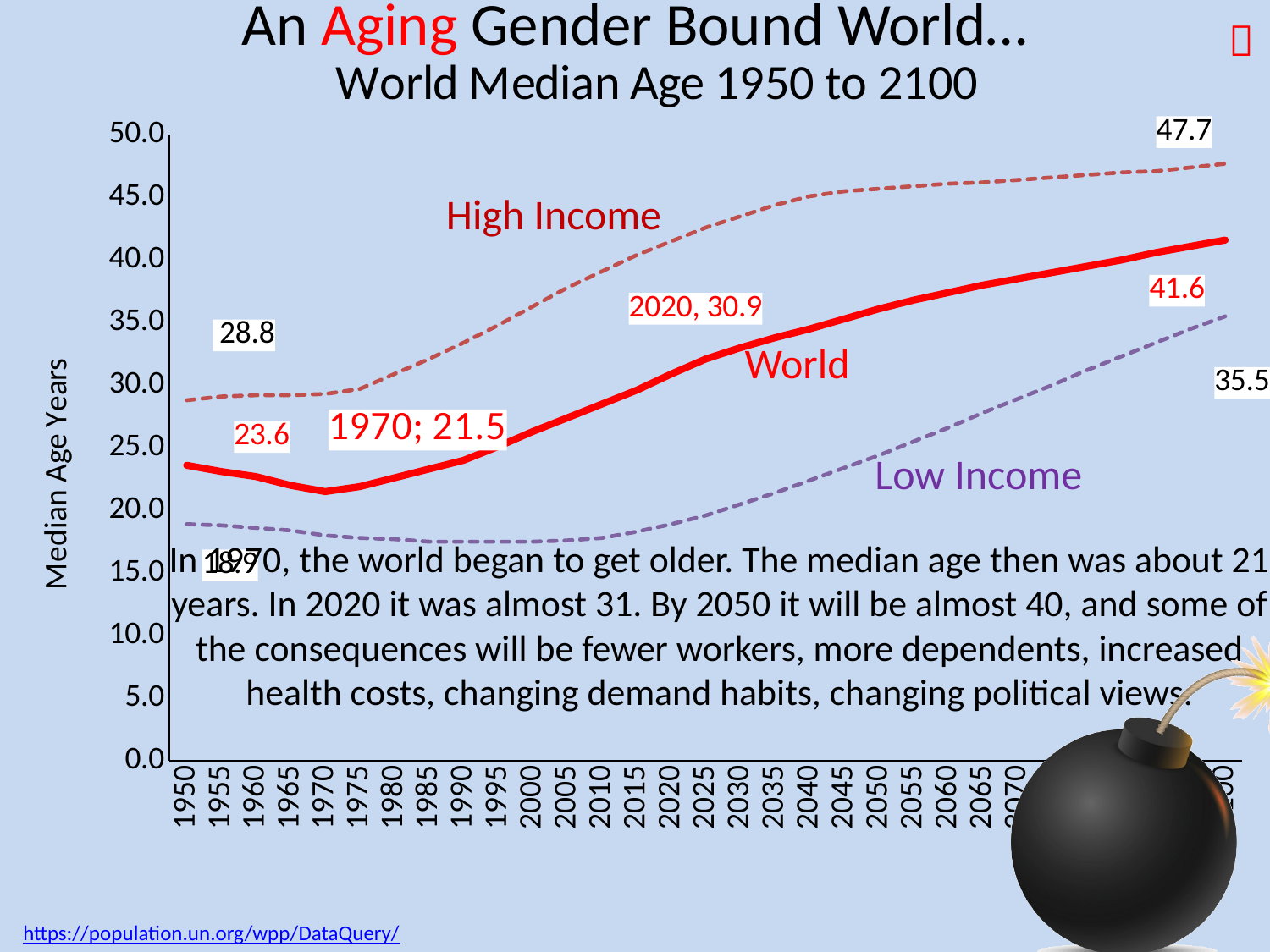
What is the World median age in 2020? 30.9 What is the difference between the High Income and World median ages in 2100? 6.1 What is the World median age in 1950? 23.6 What is the High Income median age in 2100? 47.7 What is the difference between the World median age in 2100 and in 1950? 18.0 What kind of chart is shown on the slide? line chart Which series has the highest median age in 2100? High Income What is the World median age in 1970? 21.5 Does the World median age rise or fall from 1970 to 2100? rises What is the Low Income median age in 2100? 35.5 What is the High Income median age in 1950? 28.8 What is the label on the vertical axis? Median Age Years